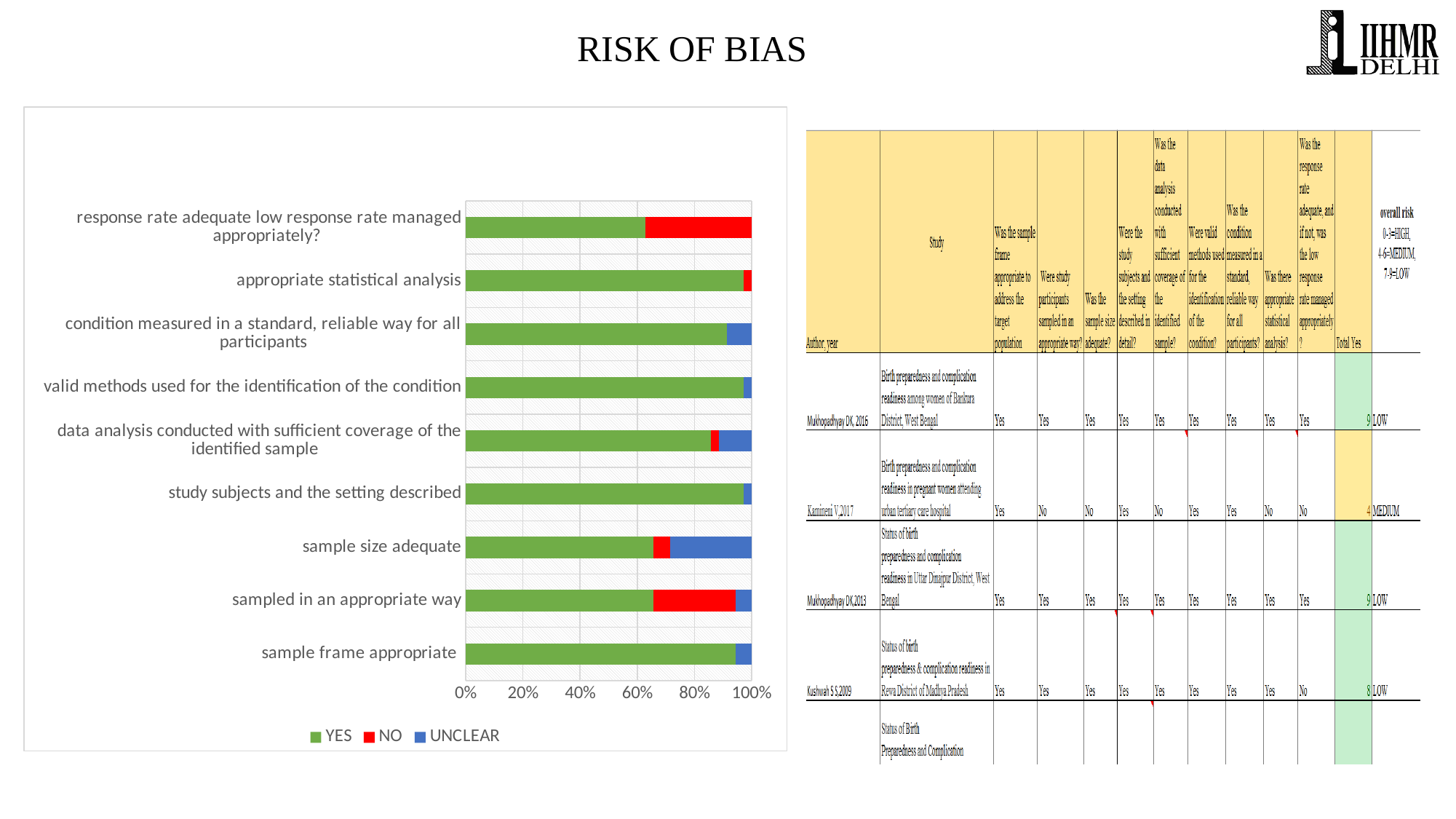
What kind of chart is shown on the left of the slide? bar chart How many series does the legend of the bar chart list? 3 How many categories does the bar chart show? 9 Is the YES value for 'sample size adequate' greater or less than 80%? less Which category has the largest NO segment in the bar chart? response rate adequate low response rate managed appropriately? Is the NO value for 'sampled in an appropriate way' greater or less than 20%? greater Is the YES value for 'response rate adequate low response rate managed appropriately?' greater or less than 80%? less What are the three series listed in the legend of the bar chart? YES, NO, UNCLEAR Which category has the largest UNCLEAR segment in the bar chart? sample size adequate Which colour represents the UNCLEAR series in the bar chart? blue